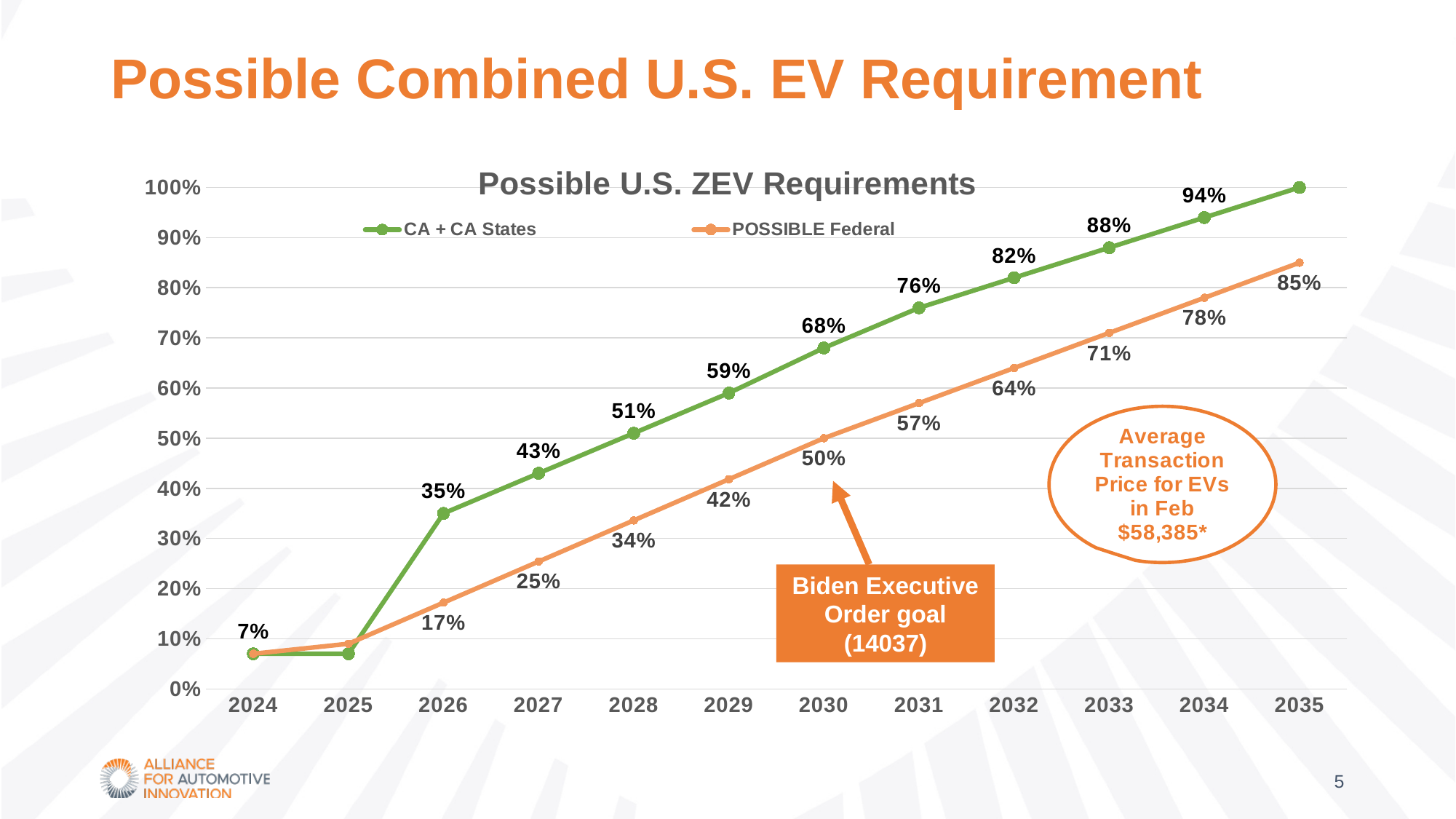
In 2028, which series has the higher value, CA + CA States or POSSIBLE Federal? CA + CA States Do the POSSIBLE Federal values rise or fall from 2026 to 2035? Rise What is the POSSIBLE Federal value for 2030? 50% What is the CA + CA States value for 2026? 35% What is the CA + CA States value for 2030? 68% In which year does the POSSIBLE Federal series reach its highest value? 2035 How many series does the legend list? 2 What kind of chart is shown? Line chart How many years are shown on the x axis? 12 What is the difference between the CA + CA States and POSSIBLE Federal values in 2030? 18 percentage points What is the POSSIBLE Federal value for 2035? 85%